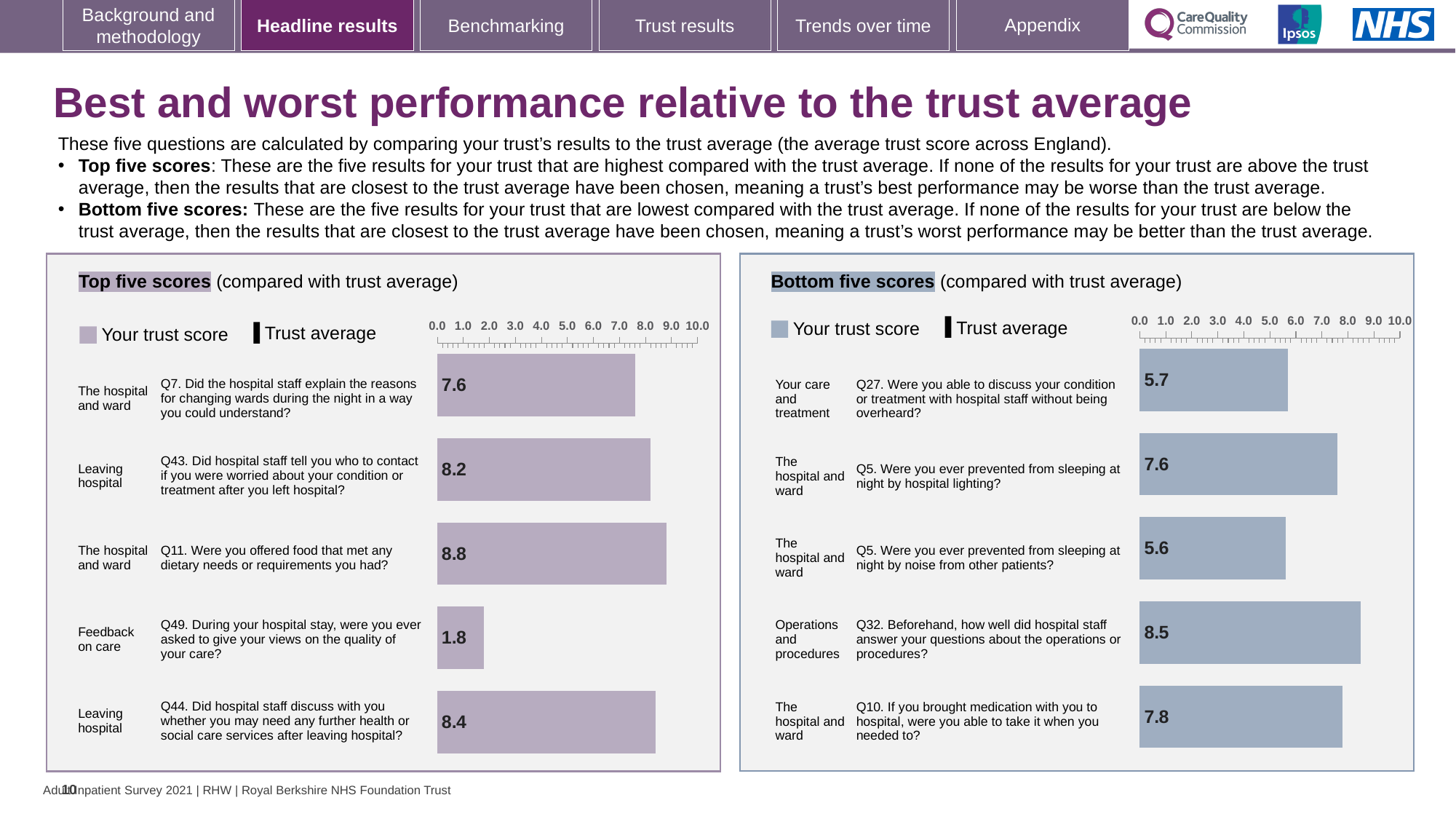
In the Top five scores chart, which question has the highest trust score? Q11 In the Top five scores chart, what is the trust score for Q11 (Were you offered food that met any dietary needs or requirements you had?)? 8.8 In the Top five scores chart, what is the difference between the trust scores for Q44 and Q43? 0.2 What kind of chart is the Bottom five scores chart? Bar chart In the Top five scores chart, what is the trust score for Q49 (During your hospital stay, were you ever asked to give your views on the quality of your care?)? 1.8 In the Bottom five scores chart, which question has the highest trust score? Q32 How many bars are plotted in the Top five scores chart? 5 In the Bottom five scores chart, which is larger: the trust score for Q27 or for Q10? Q10 In the Bottom five scores chart, what is the difference between the trust scores for Q32 and Q27? 2.8 In the Bottom five scores chart, what is the trust score for Q32 (Beforehand, how well did hospital staff answer your questions about the operations or procedures?)? 8.5 In the Bottom five scores chart, what is the trust score for Q5 about being prevented from sleeping at night by noise from other patients? 5.6 In the Top five scores chart, which question has the lowest trust score? Q49